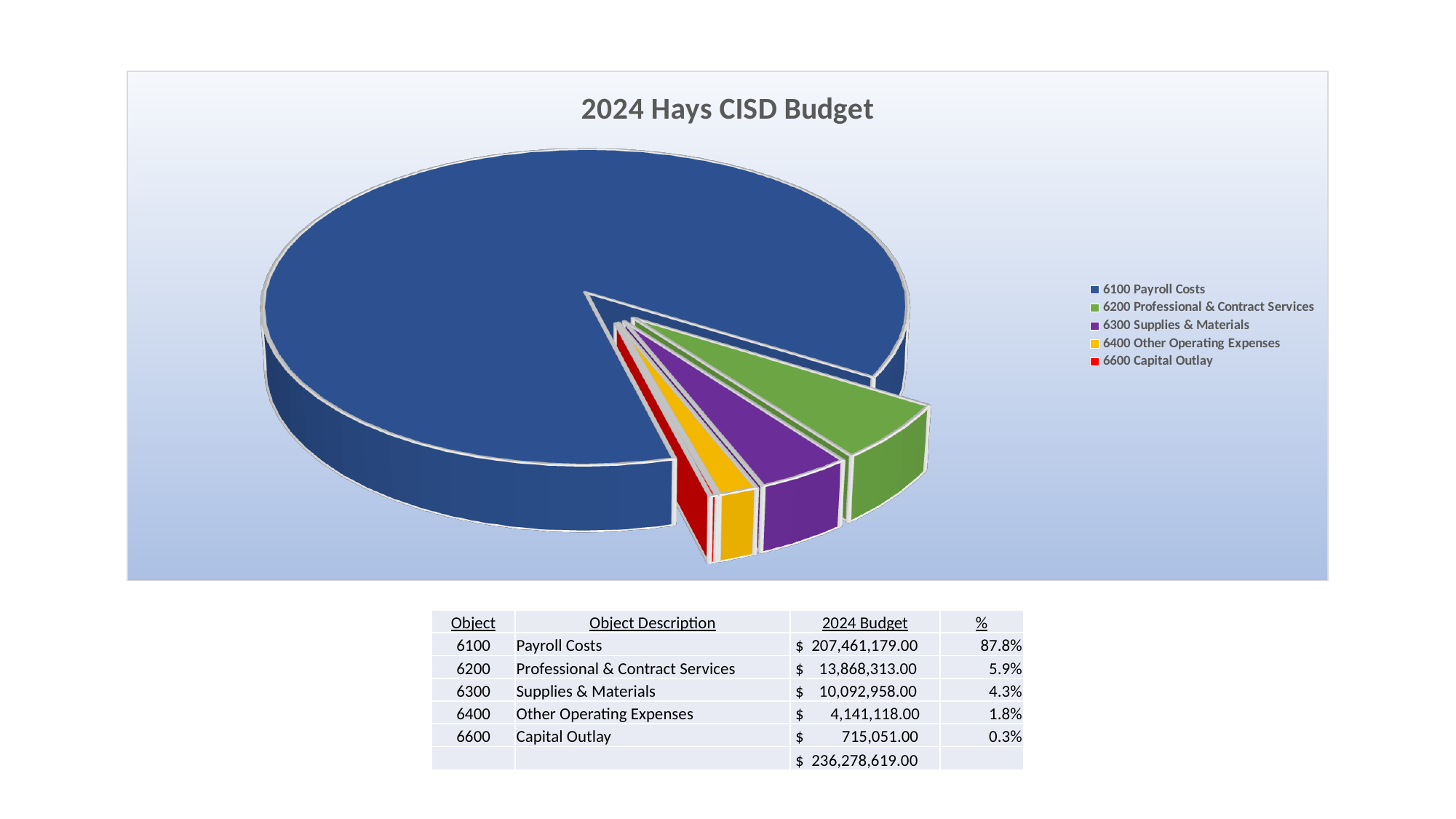
What is the title of the chart? 2024 Hays CISD Budget Which is larger, the slice for Supplies & Materials or the slice for Other Operating Expenses? Supplies & Materials What is the 2024 budget amount for Professional & Contract Services? $ 13,868,313.00 Which category has the smallest slice of the pie? 6600 Capital Outlay How many categories does the legend of the pie chart list? 5 Which category has the largest slice of the pie? 6100 Payroll Costs What is the 2024 budget amount for Capital Outlay? $ 715,051.00 What colour is the slice for 6400 Other Operating Expenses? yellow What kind of chart is shown on the slide? pie chart What is the total 2024 budget shown in the table? $ 236,278,619.00 What share of the 2024 budget is Payroll Costs? 87.8% What share of the 2024 budget is Supplies & Materials? 4.3%